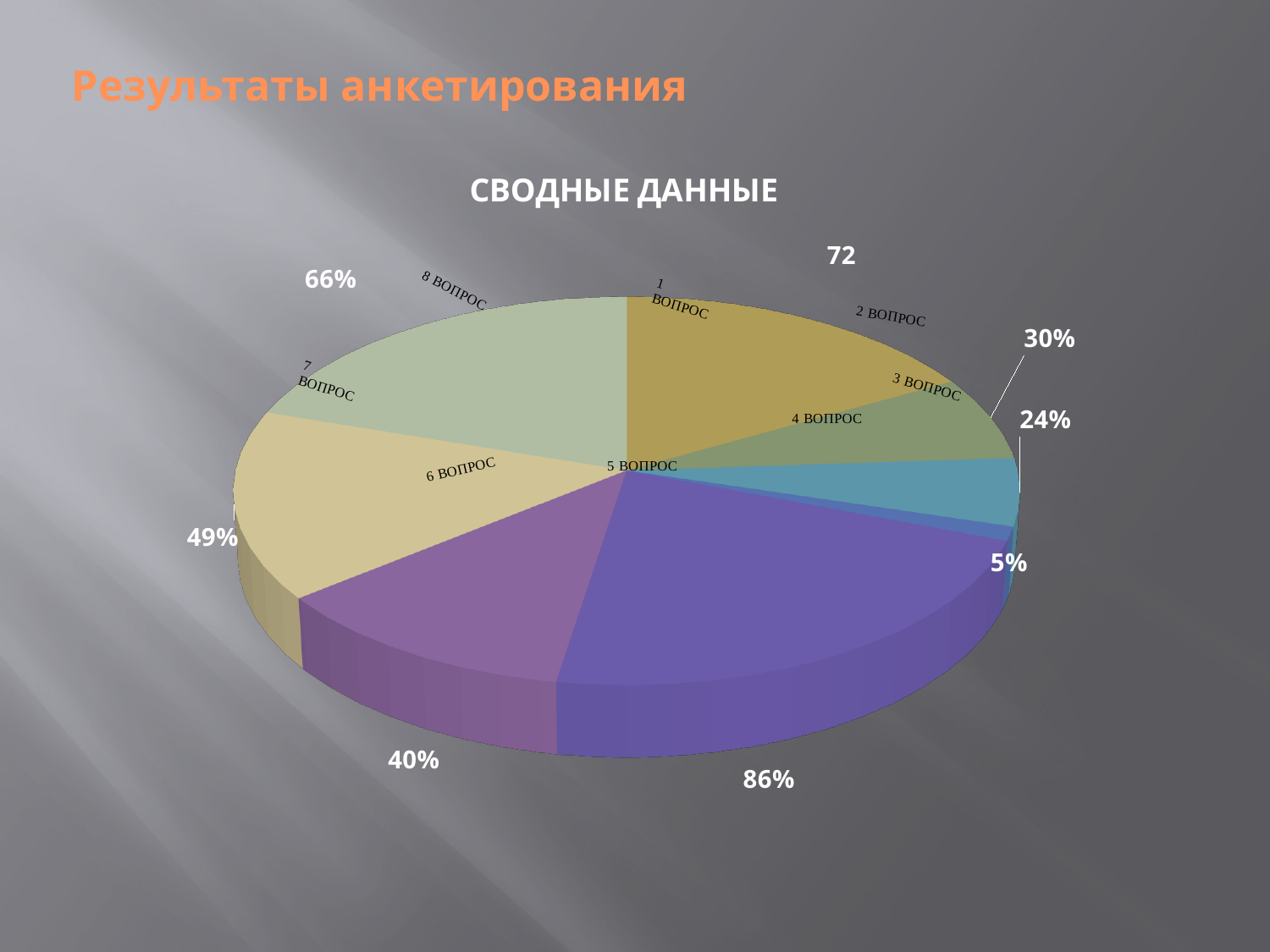
What value is shown for 4 ВОПРОС? 5% What value is shown for 5 ВОПРОС? 86% What value is shown for 1 ВОПРОС? 72 Which category has the largest slice in the pie chart? 5 ВОПРОС Which is larger, the value for 2 ВОПРОС or the value for 3 ВОПРОС? 2 ВОПРОС What type of chart is shown on the slide? Pie chart What is the difference between the values for 7 ВОПРОС and 6 ВОПРОС? 9% What is the title of the chart? СВОДНЫЕ ДАННЫЕ What value is shown for 6 ВОПРОС? 40% Which category has the smallest slice in the pie chart? 4 ВОПРОС How many slices does the pie chart have? 8 What value is shown for 8 ВОПРОС? 66%